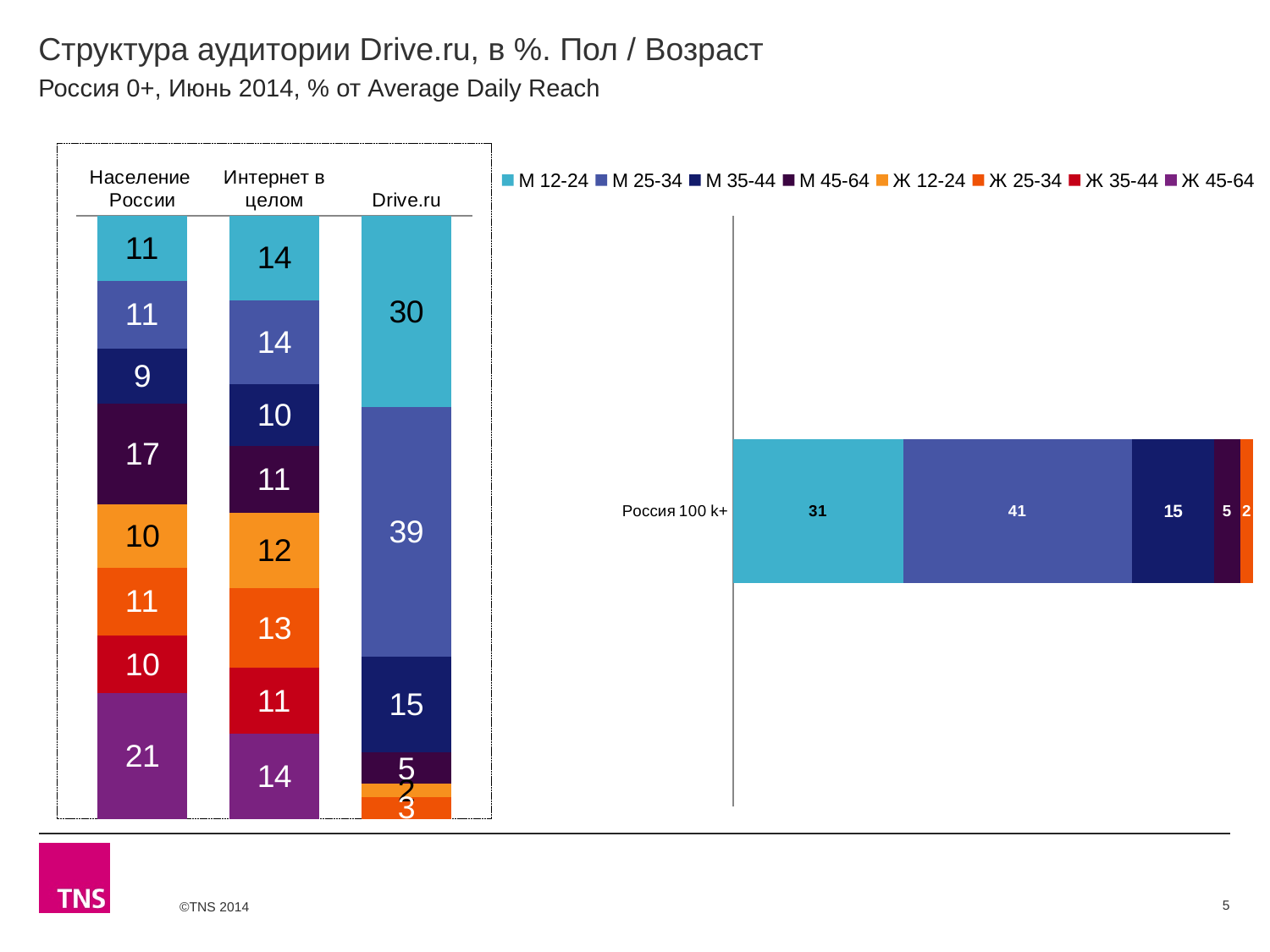
On the left chart, what is the value of М 35-44 for Интернет в целом? 10 On the right chart (Россия 100 k+), what is the value of М 12-24? 31 On the right chart (Россия 100 k+), what is the difference between М 25-34 and М 35-44? 26 On the left chart, what is the value of Ж 45-64 for Население России? 21 On the left chart, what is the value of М 12-24 for Drive.ru? 30 What kind of chart is the left chart? Stacked bar chart On the left chart, what is the difference between М 25-34 for Drive.ru and М 25-34 for Население России? 28 On the left chart, which segment is the smallest in the Население России bar? М 35-44 On the left chart, which segment is the largest in the Drive.ru bar? М 25-34 On the right chart (Россия 100 k+), what is the value of М 25-34? 41 How many series does the legend list? 8 On the left chart, which is larger: М 45-64 for Население России or М 45-64 for Интернет в целом? Население России